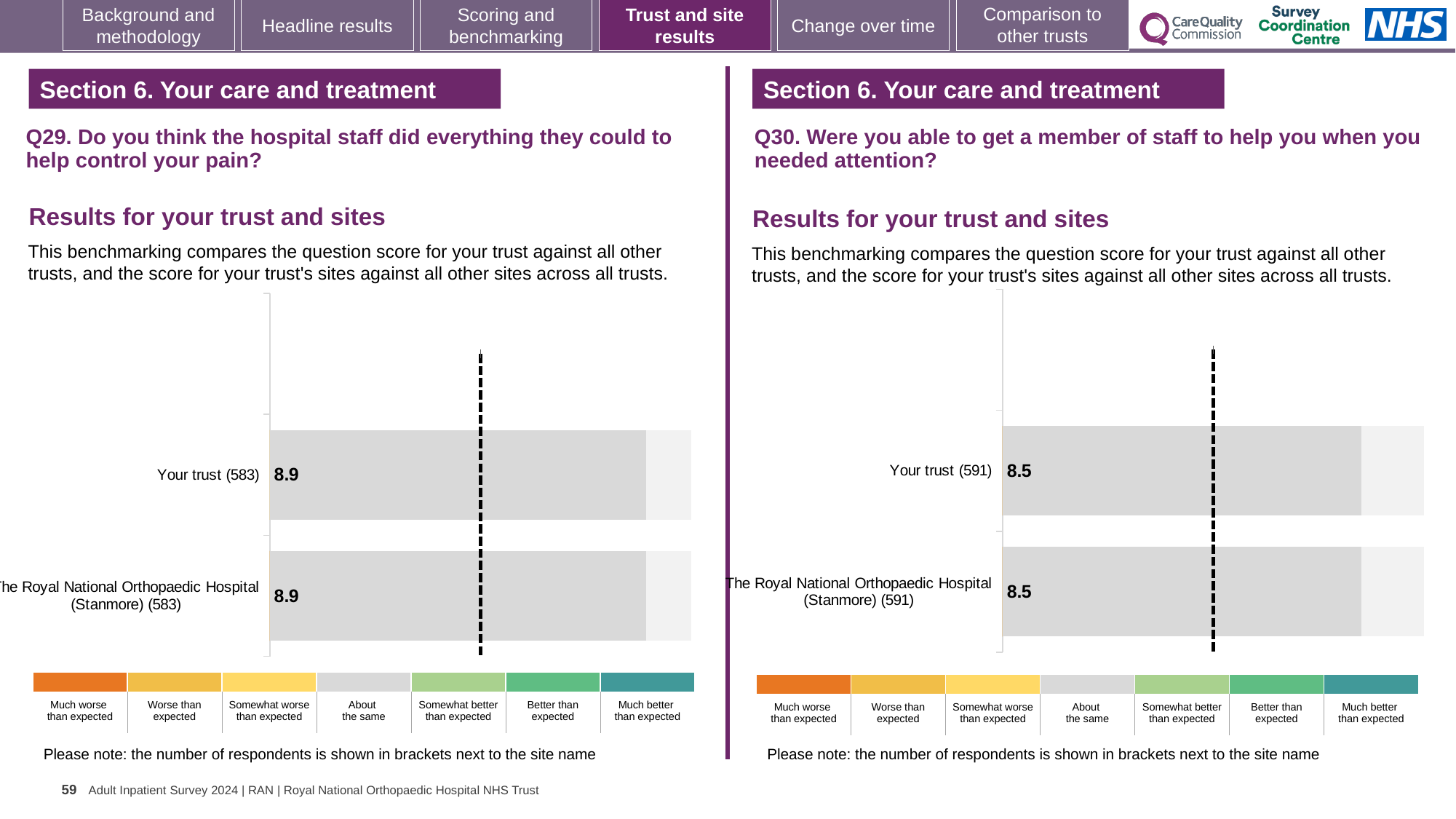
In the Q29 chart on the left, what is the score for Your trust? 8.9 What kind of chart is the Q29 chart on the left? Bar chart How many bars are plotted in the Q30 chart on the right? 2 How many bars are plotted in the Q29 chart on the left? 2 How many categories does the colour legend below the Q30 chart on the right list? 7 In the Q30 chart on the right, what is the score for Your trust? 8.5 In the Q29 chart on the left, how many respondents are shown in brackets for Your trust? 583 In the Q29 chart on the left, what is the score for The Royal National Orthopaedic Hospital (Stanmore)? 8.9 In the Q29 chart on the left, what is the difference between the score for Your trust and the score for The Royal National Orthopaedic Hospital (Stanmore)? 0.0 In the Q30 chart on the right, what is the score for The Royal National Orthopaedic Hospital (Stanmore)? 8.5 In the Q30 chart on the right, what is the difference between the score for Your trust and the score for The Royal National Orthopaedic Hospital (Stanmore)? 0.0 In the Q30 chart on the right, how many respondents are shown in brackets for The Royal National Orthopaedic Hospital (Stanmore)? 591